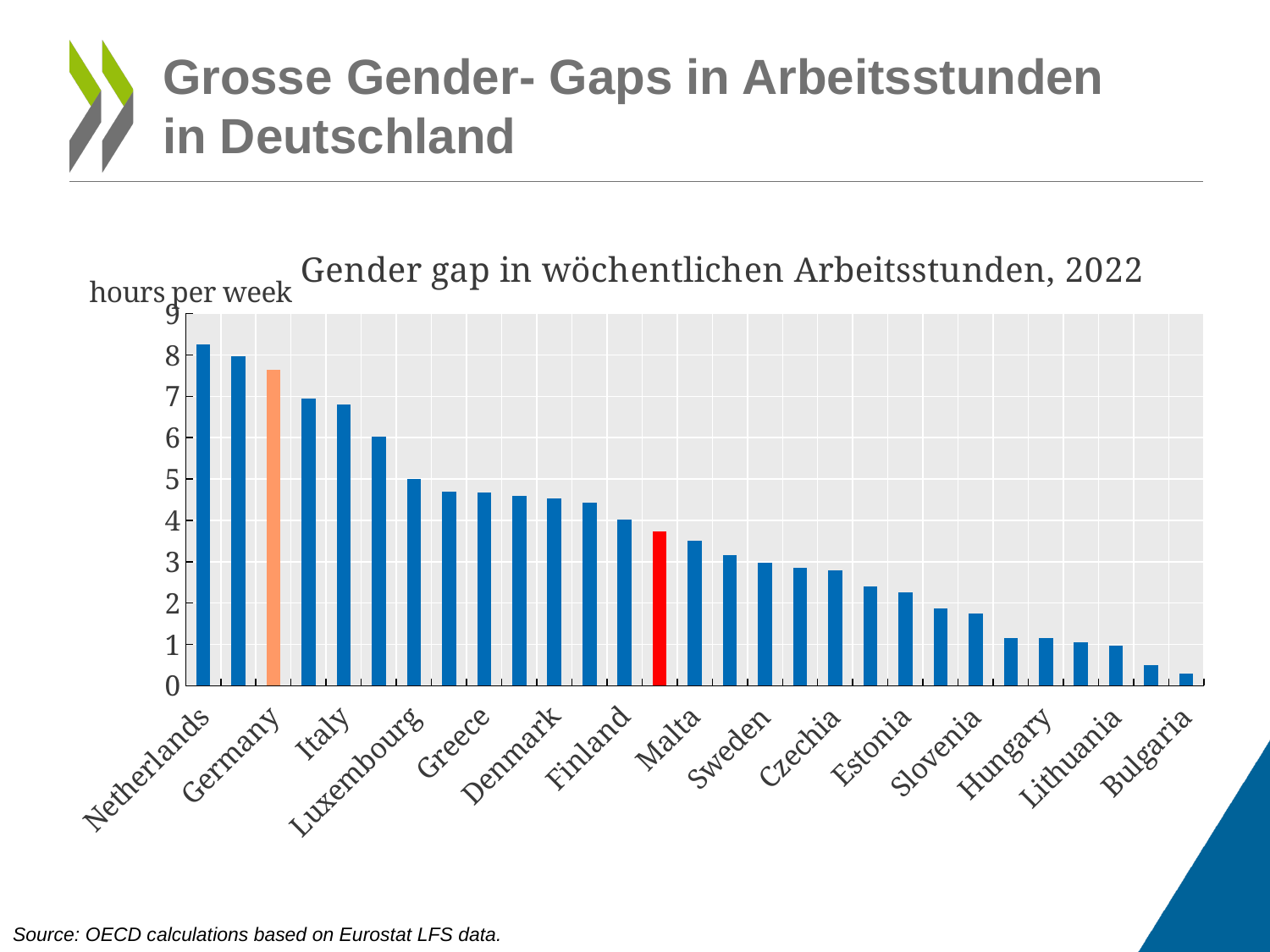
Is the value for Italy greater or less than 7? less What unit is shown on the y axis of the chart? hours per week Is the value for Netherlands greater or less than 8? greater Which has a larger gender gap in weekly working hours, Netherlands or Germany? Netherlands Which country has the largest gender gap in weekly working hours? Netherlands Is the value for Germany greater or less than 7? greater Do the values rise or fall moving from left to right along the x axis? Fall What kind of chart is shown on the slide? Bar chart Which country has the smallest gender gap in weekly working hours? Bulgaria